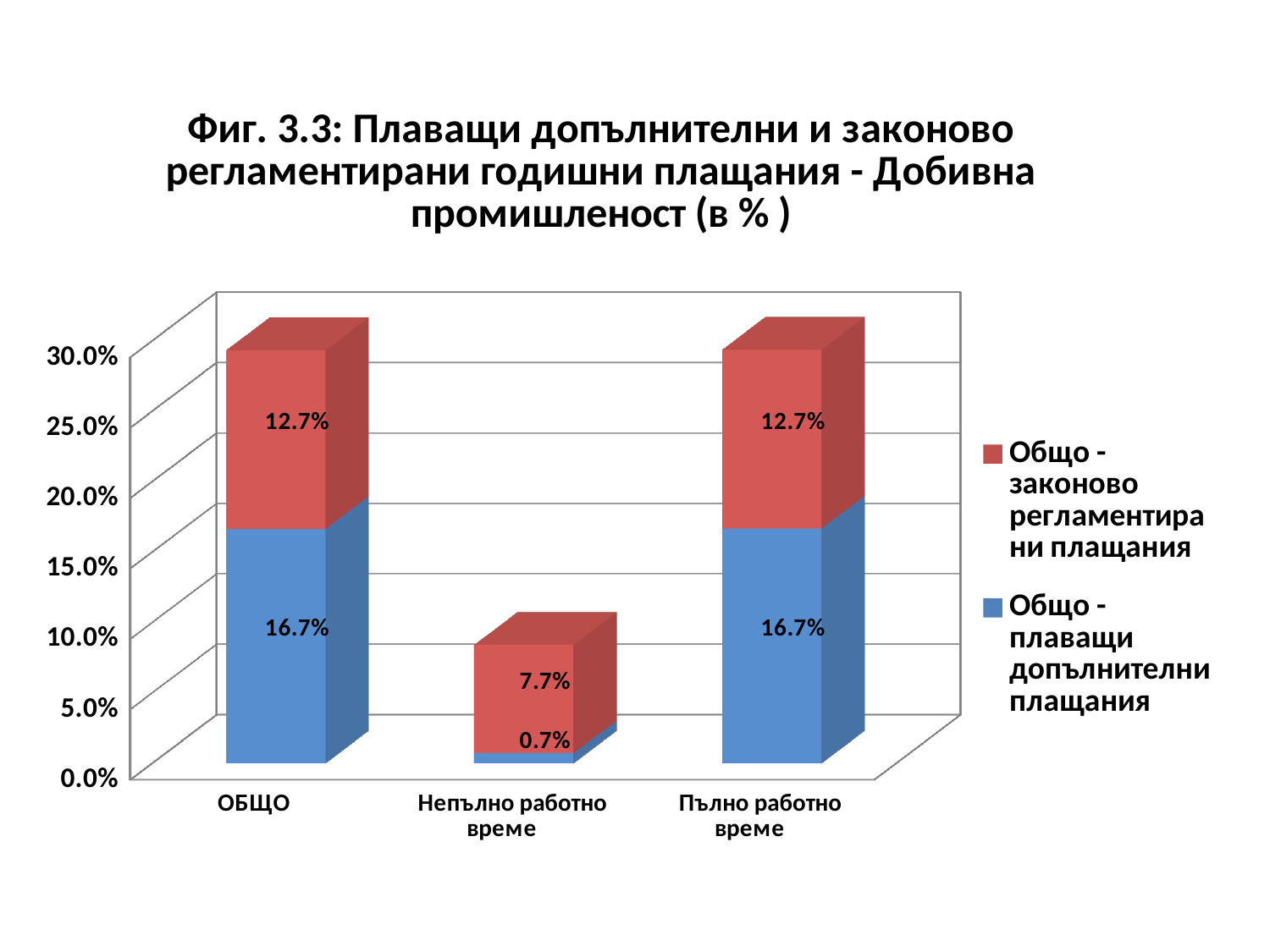
For 'Пълно работно време', which is larger: 'Общо - плаващи допълнителни плащания' or 'Общо - законово регламентирани плащания'? Общо - плаващи допълнителни плащания What is the difference between 'Общо - законово регламентирани плащания' and 'Общо - плаващи допълнителни плащания' for 'Непълно работно време'? 7.0% How many categories are shown on the x axis? 3 What is the difference between 'Общо - плаващи допълнителни плащания' and 'Общо - законово регламентирани плащания' for 'ОБЩО'? 4.0% What is the value of 'Общо - плаващи допълнителни плащания' for 'Пълно работно време'? 16.7% What is the value of 'Общо - плаващи допълнителни плащания' for 'Непълно работно време'? 0.7% What is the value of 'Общо - законово регламентирани плащания' for 'Непълно работно време'? 7.7% What is the value of 'Общо - законово регламентирани плащания' for 'ОБЩО'? 12.7% Which category has the lowest value for 'Общо - плаващи допълнителни плащания'? Непълно работно време What is the total of the stacked bar for 'Непълно работно време'? 8.4% What is the total of the stacked bar for 'ОБЩО'? 29.4% What kind of chart is shown on the slide? Stacked bar chart